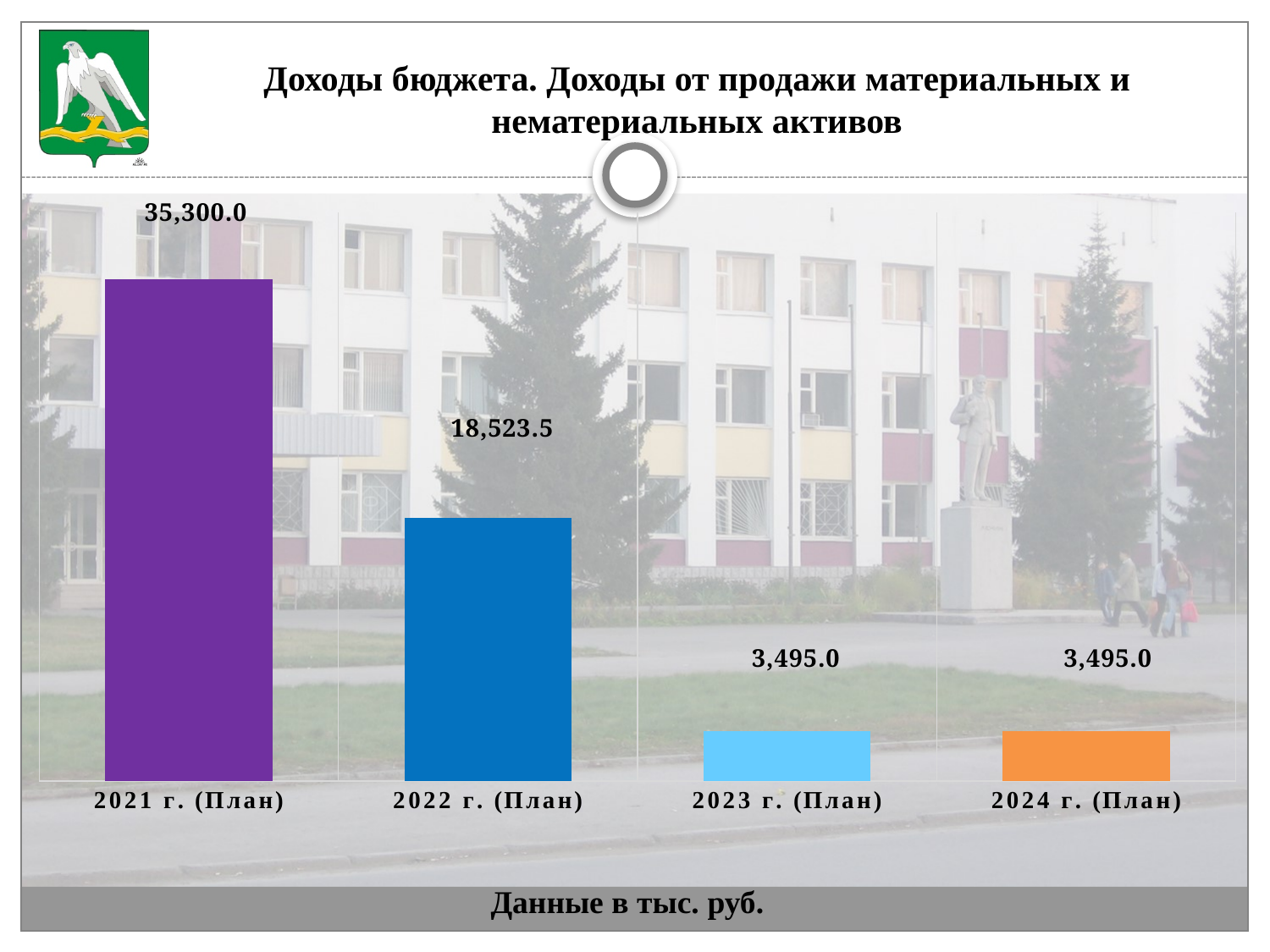
In what units are the data on the chart given, according to the slide? тыс. руб. What is the value for 2024 г. (План)? 3,495.0 Which is larger, the value for 2022 г. (План) or the value for 2024 г. (План)? 2022 г. (План) Which category has the highest value? 2021 г. (План) What kind of chart is shown on the slide? Bar chart Do the values rise or fall from 2021 г. (План) to 2023 г. (План)? Fall What is the value for 2022 г. (План)? 18,523.5 How many categories are shown in the chart? 4 What is the difference between the values for 2021 г. (План) and 2022 г. (План)? 16,776.5 What is the difference between the values for 2022 г. (План) and 2023 г. (План)? 15,028.5 What is the value for 2023 г. (План)? 3,495.0 What is the value for 2021 г. (План)? 35,300.0